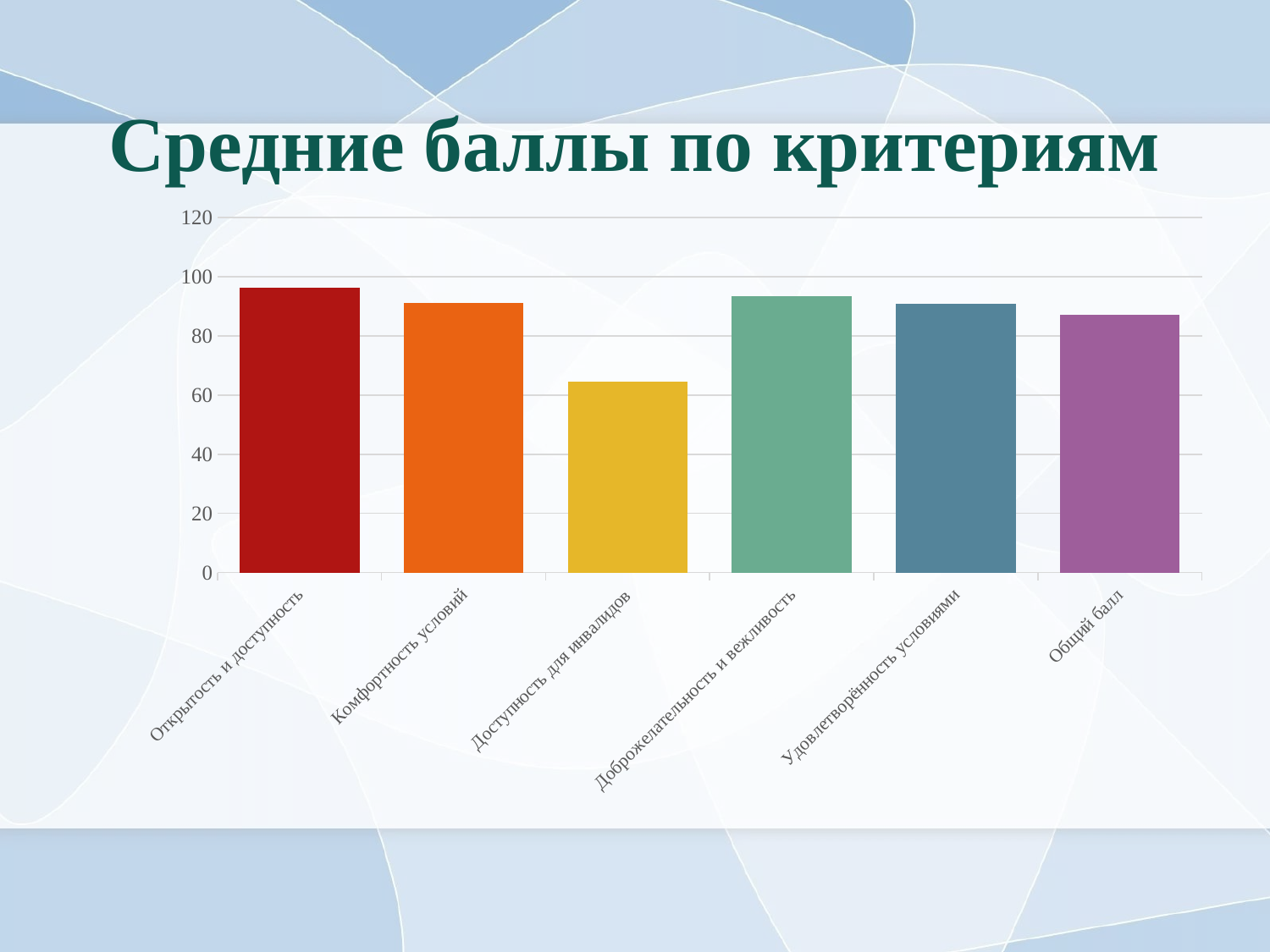
How many categories are plotted in the chart? 6 Which category has the highest value? Открытость и доступность Is the value for Открытость и доступность greater or less than 100? less Is the value for Доступность для инвалидов greater or less than 80? less Is the value for Доступность для инвалидов greater or less than 60? greater What is the title of the chart? Средние баллы по критериям Which is larger, the value for Открытость и доступность or the value for Доступность для инвалидов? Открытость и доступность What kind of chart is shown on the slide? bar chart Which is larger, the value for Доброжелательность и вежливость or the value for Общий балл? Доброжелательность и вежливость What colour is the bar for Доступность для инвалидов? yellow Which category has the lowest value? Доступность для инвалидов